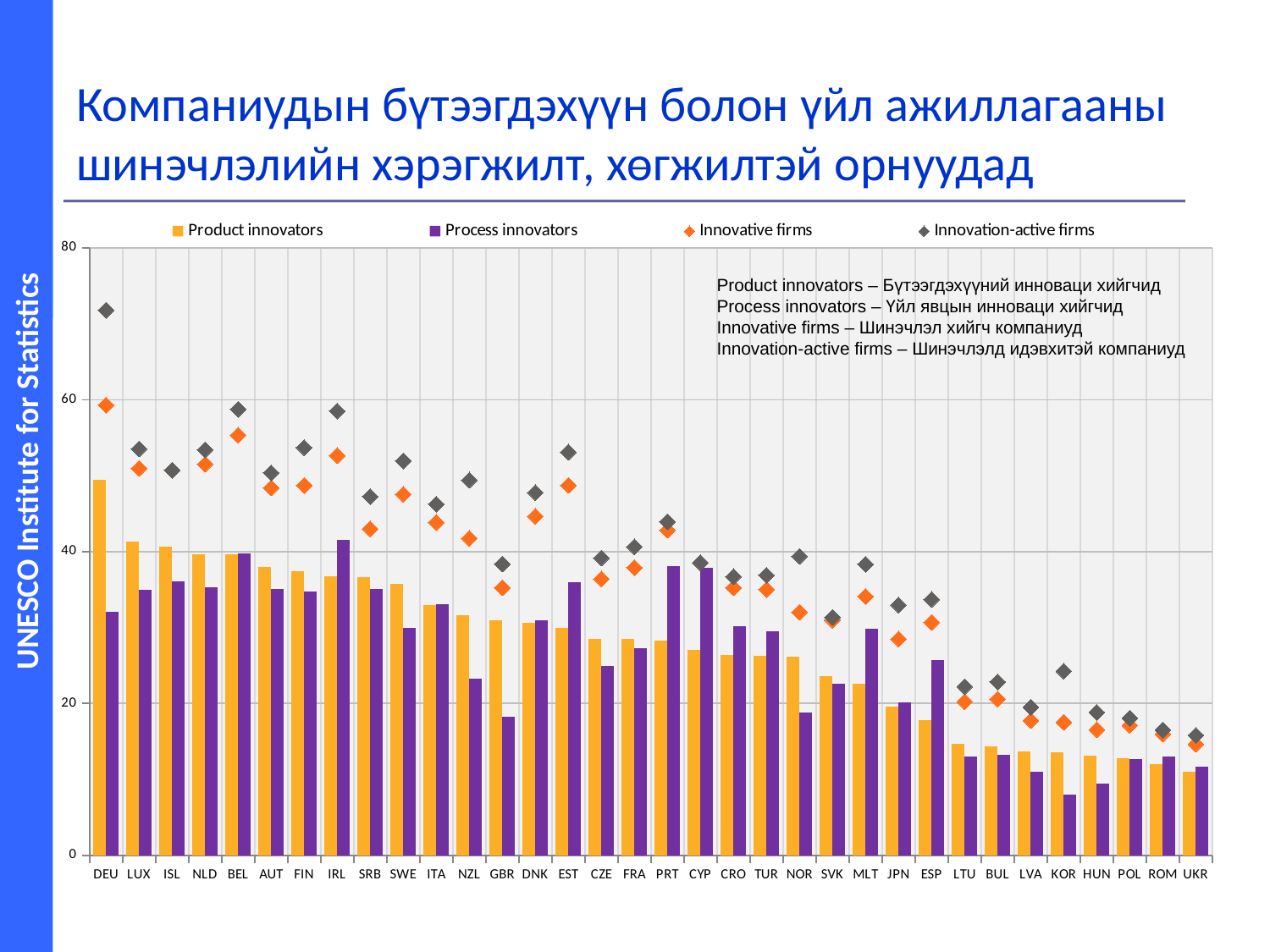
For DEU, which is larger: Product innovators or Process innovators? Product innovators Is the Process innovators value for KOR greater or less than 20? less Which country has the highest value for Innovation-active firms? DEU Is the Innovative firms value for BEL greater or less than 40? greater Is the Innovation-active firms value for DEU greater or less than 60? greater Which country has the highest value for Product innovators? DEU How many series does the chart legend list? 4 How many countries are shown on the x axis of the chart? 34 Do the Product innovators values generally rise or fall from left to right along the x axis? fall For PRT, which is larger: Product innovators or Process innovators? Process innovators Which series is shown with orange diamond markers? Innovative firms